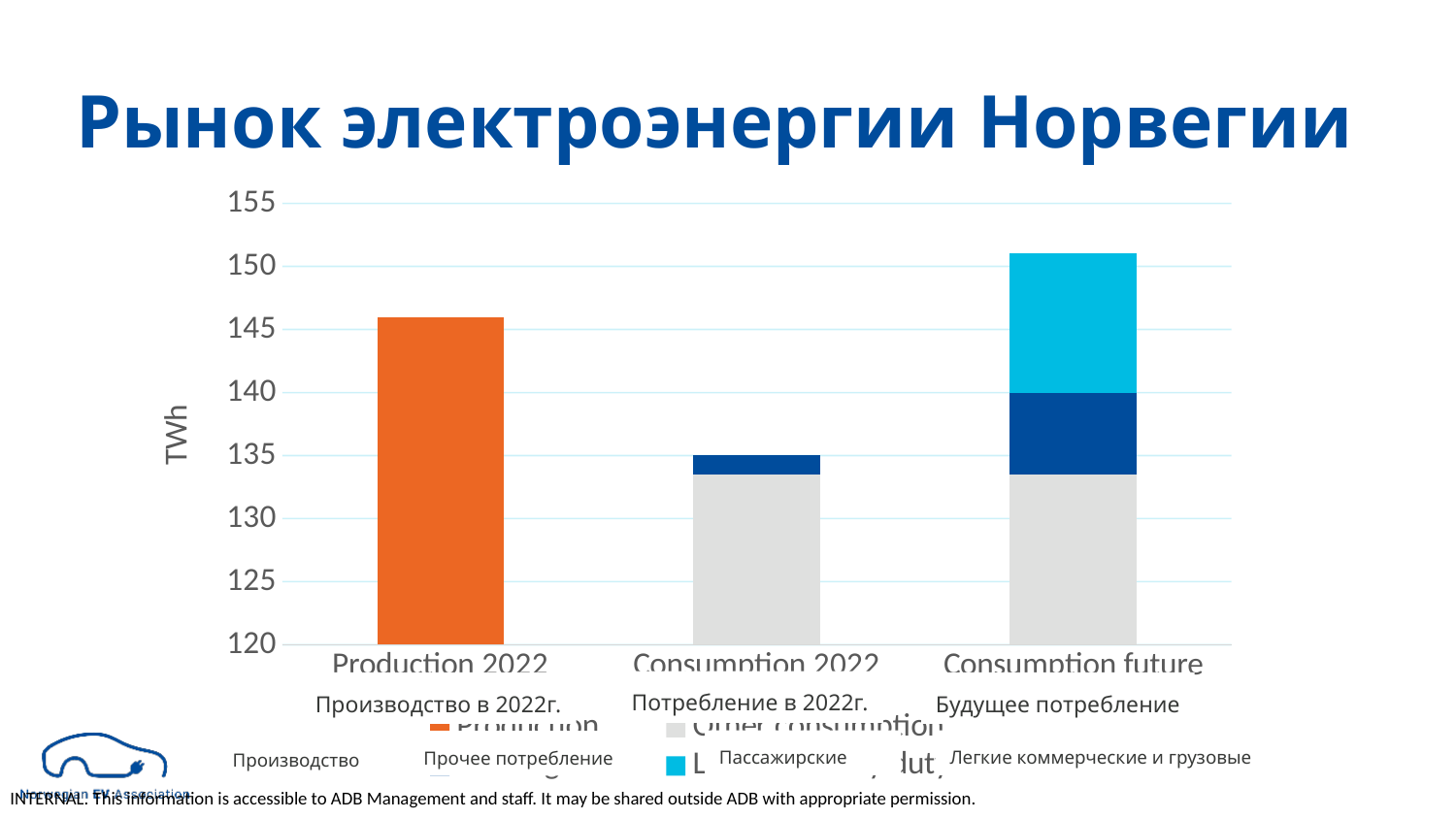
Which is larger, the bar for Production 2022 or the total bar for Consumption 2022? Production 2022 Is the total for Consumption 2022 greater or less than 140? less Which is larger, the bar for Production 2022 or the total bar for Consumption future? Consumption future Which category has the lowest total bar? Consumption 2022 How many series does the chart's legend list? 4 Is the total for Consumption future greater or less than 145? greater Does the total consumption rise or fall from Consumption 2022 to Consumption future? Rise What unit is shown on the y axis of the chart? TWh Is the value for Production 2022 greater or less than 140? greater Which category has the highest total bar? Consumption future How many categories are shown on the x axis of the chart? 3 What kind of chart is shown on the slide? Stacked bar chart